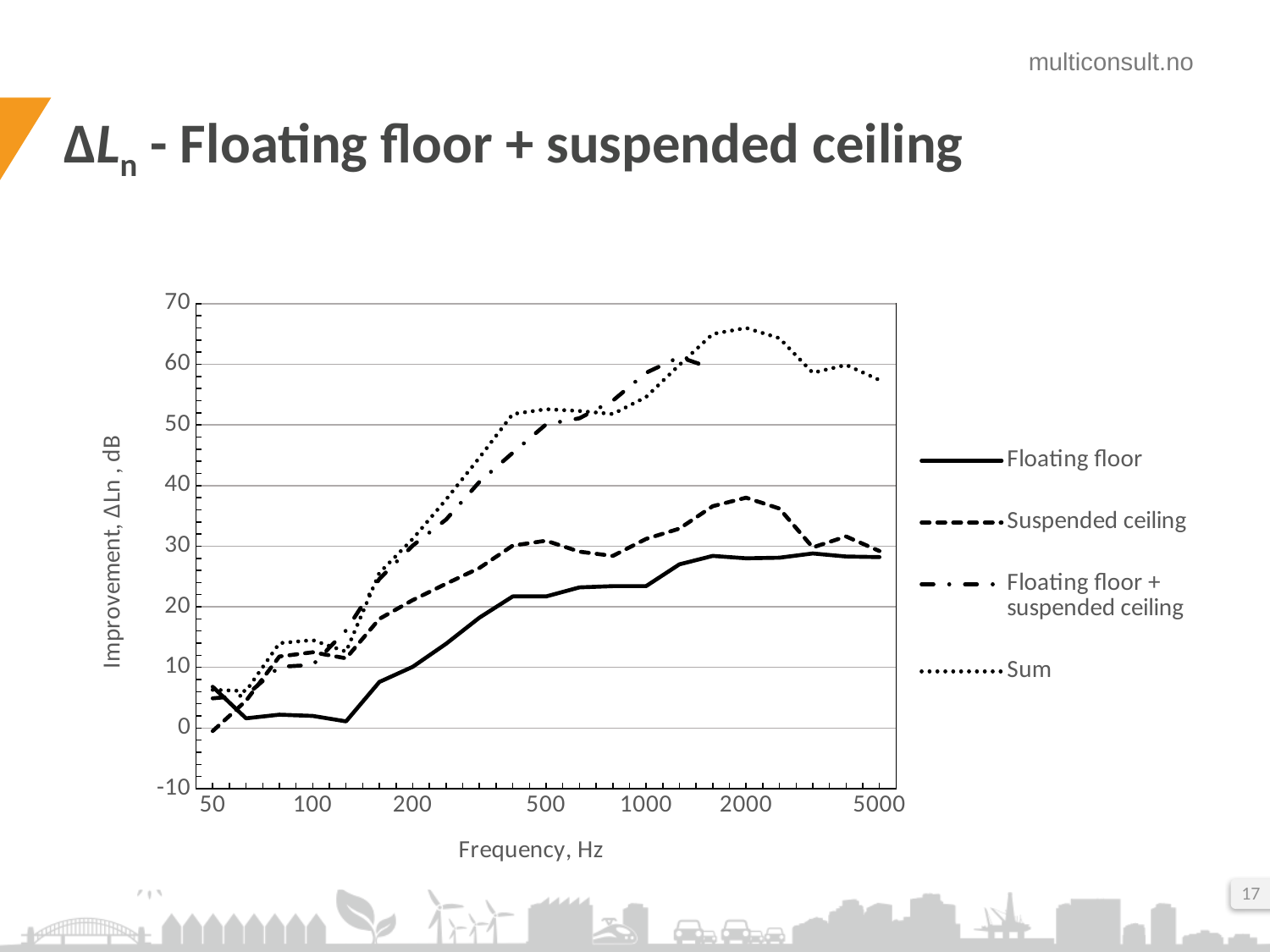
Which series is drawn with a solid line? Floating floor How many series does the legend list? 4 Is the value for Sum at 2000 Hz greater or less than 60? greater Which series reaches the highest value on the chart? Sum Is the value for Floating floor at 5000 Hz greater or less than 30? less What is the title of the x axis? Frequency, Hz At 1000 Hz, which is larger: Suspended ceiling or Floating floor? Suspended ceiling What kind of chart is shown on the slide? line chart Is the value for Suspended ceiling at 2000 Hz greater or less than 40? less Does the Sum series rise or fall between 2000 Hz and 5000 Hz? fall Which series has the lowest value at 5000 Hz? Floating floor